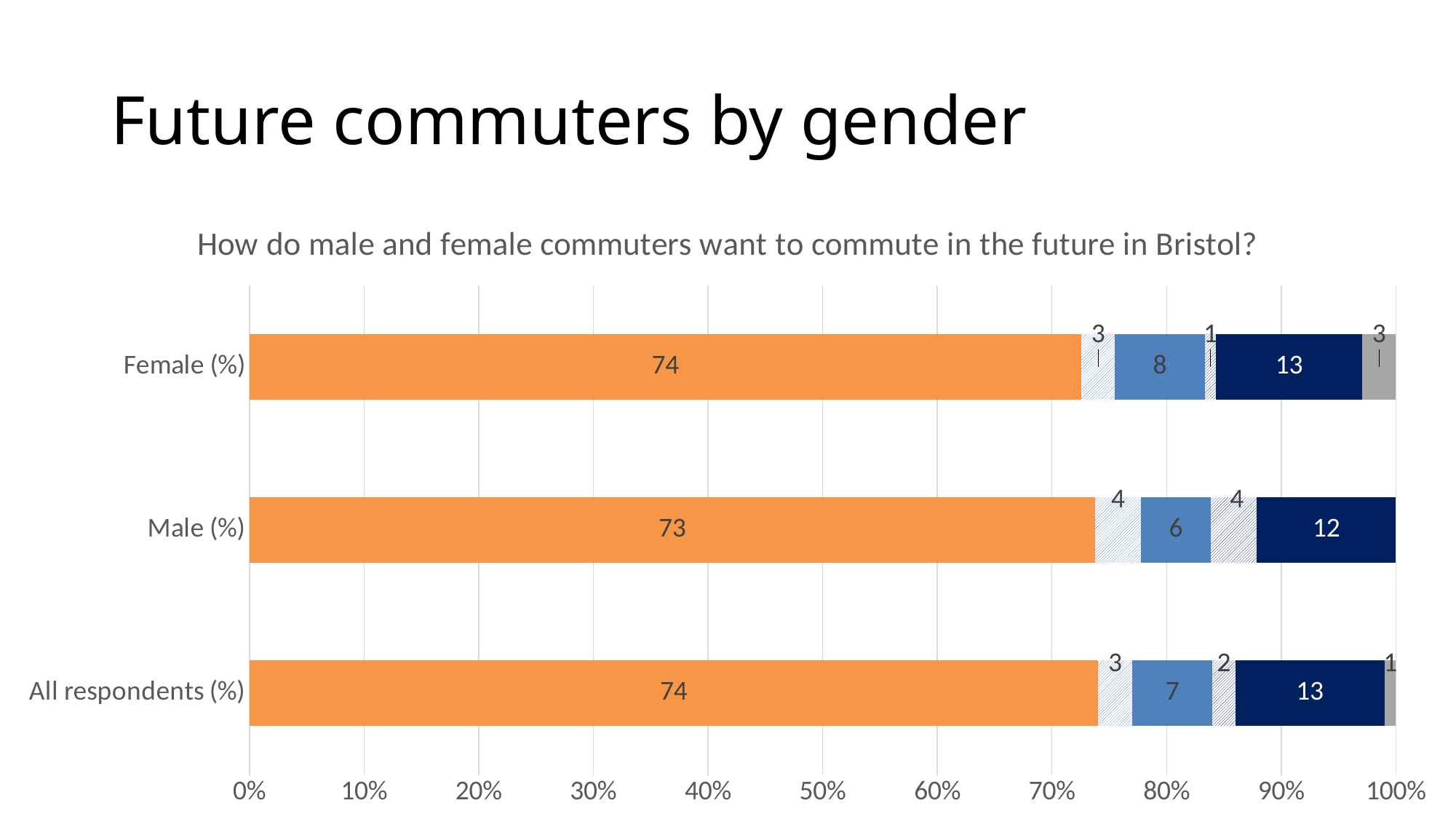
What is the difference between the medium blue segment values for Female (%) and Male (%)? 2 What is the value of the orange (first) segment for Male (%)? 73 What is the value of the orange (first) segment for Female (%)? 74 What kind of chart is shown on the slide? Stacked bar chart What is the title of the chart? How do male and female commuters want to commute in the future in Bristol? What is the value of the dark navy segment for Male (%)? 12 How many categories are shown on the vertical axis? 3 Is the orange (first) segment for Male (%) greater or less than 70%? greater What is the value of the medium blue segment for All respondents (%)? 7 Which category has the lowest value for the orange (first) segment? Male (%) What is the value of the dark navy segment for Female (%)? 13 Which is larger: the dark navy segment for Female (%) or for Male (%)? Female (%)